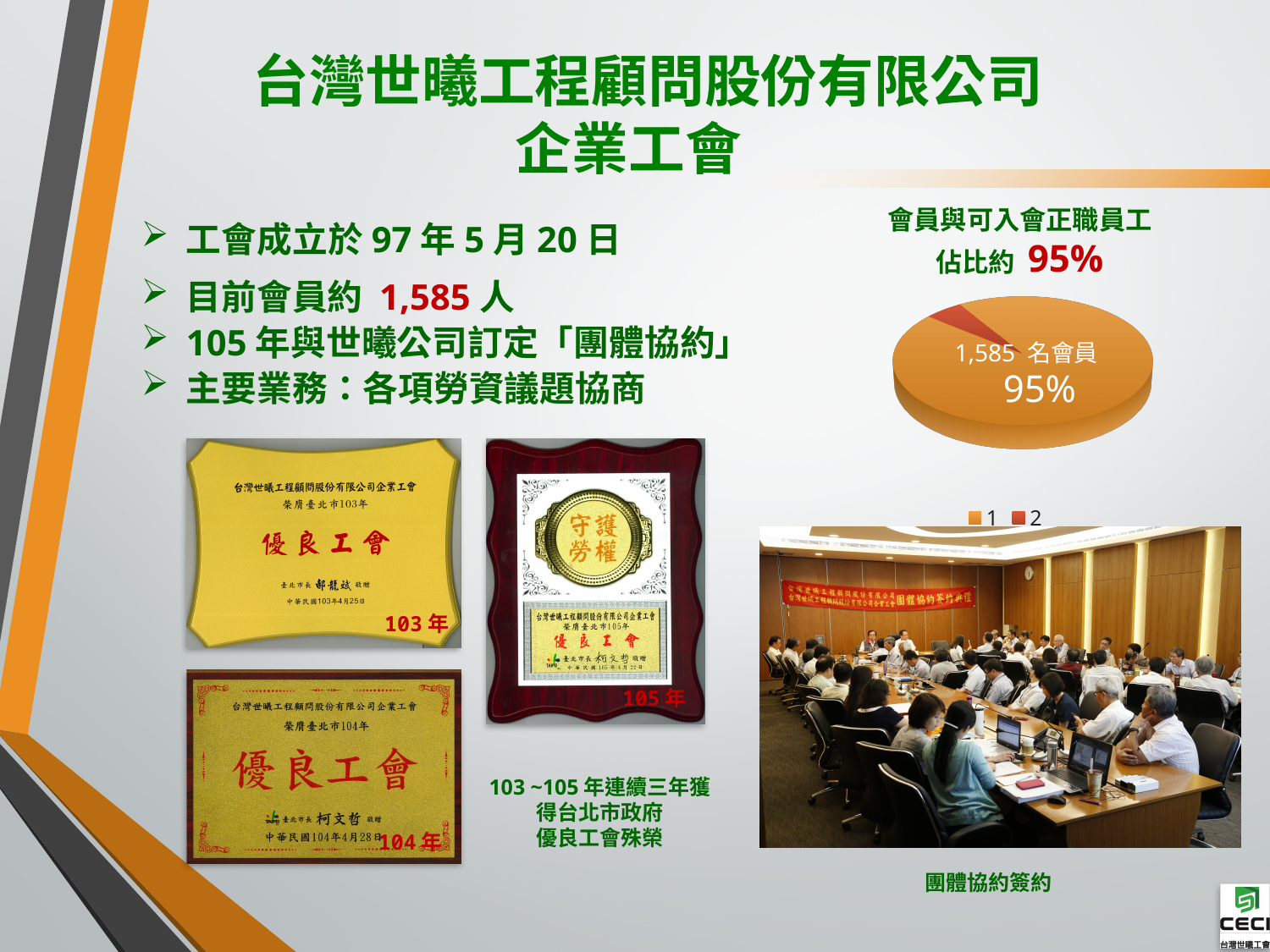
What colour is the large slice of the pie chart? orange Which legend entry corresponds to the smallest slice of the pie chart? 2 What percentage is printed on the large orange slice of the pie chart? 95% What kind of chart is shown on the slide? pie chart How many entries does the legend of the pie chart list? 2 Which slice of the pie chart is larger, the orange one or the red one? the orange one How many members does the label on the large slice of the pie chart state? 1,585 名會員 How many slices does the pie chart have? 2 What are the entries listed in the legend of the pie chart? 1 and 2 Which legend entry corresponds to the largest slice of the pie chart? 1